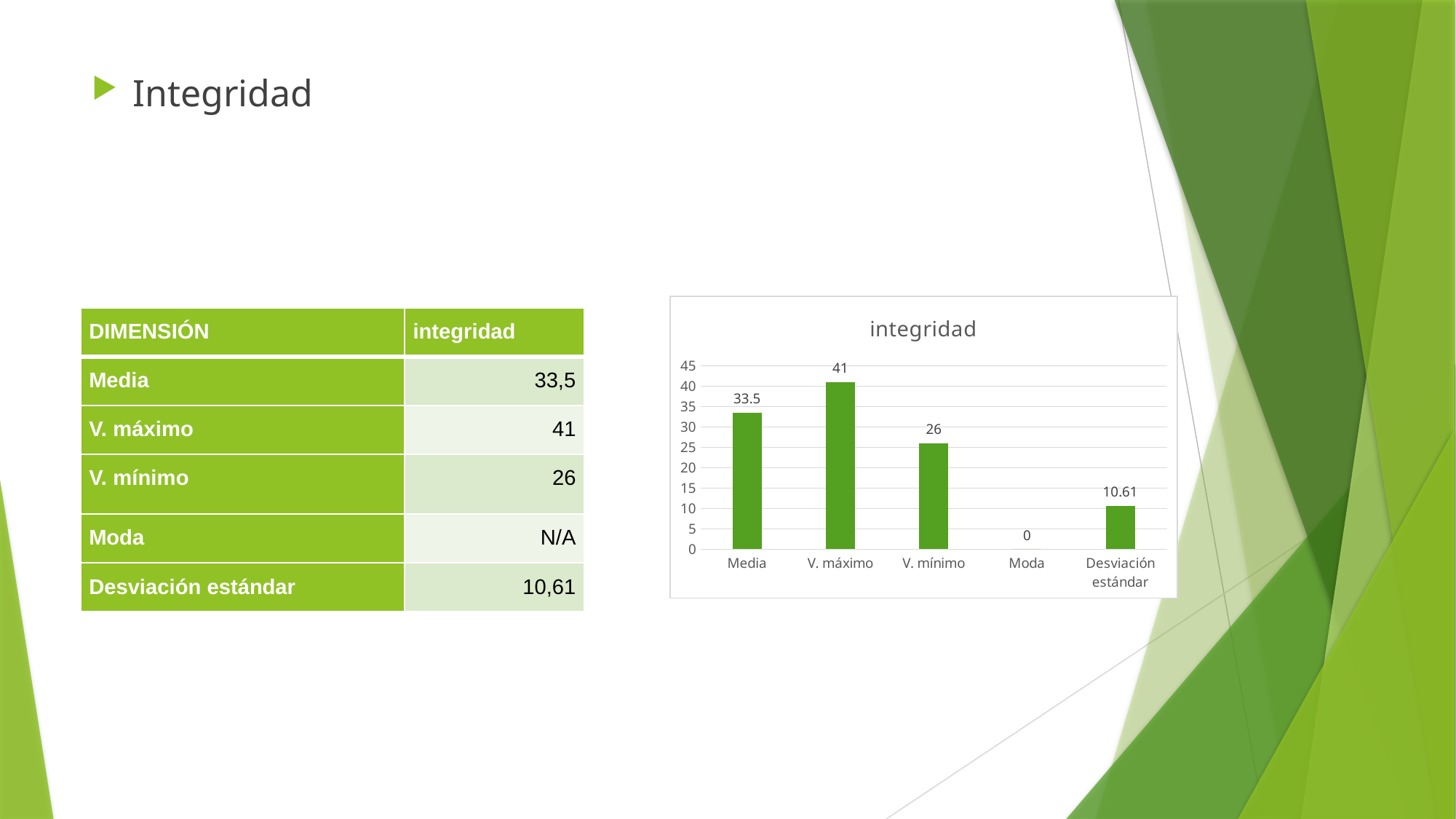
What is the value for Media in the chart? 33.5 What is the title of the chart? integridad Which category has the highest value in the chart? V. máximo What is the value for V. mínimo in the chart? 26 Which category has the lowest value in the chart? Moda What is the value for Desviación estándar in the chart? 10.61 How many categories are shown on the x axis of the chart? 5 What is the value shown for Moda in the chart? 0 What is the value for V. máximo in the chart? 41 What kind of chart is shown on the slide? Bar chart Which is larger in the chart, Media or V. mínimo? Media What is the difference between V. máximo and V. mínimo in the chart? 15